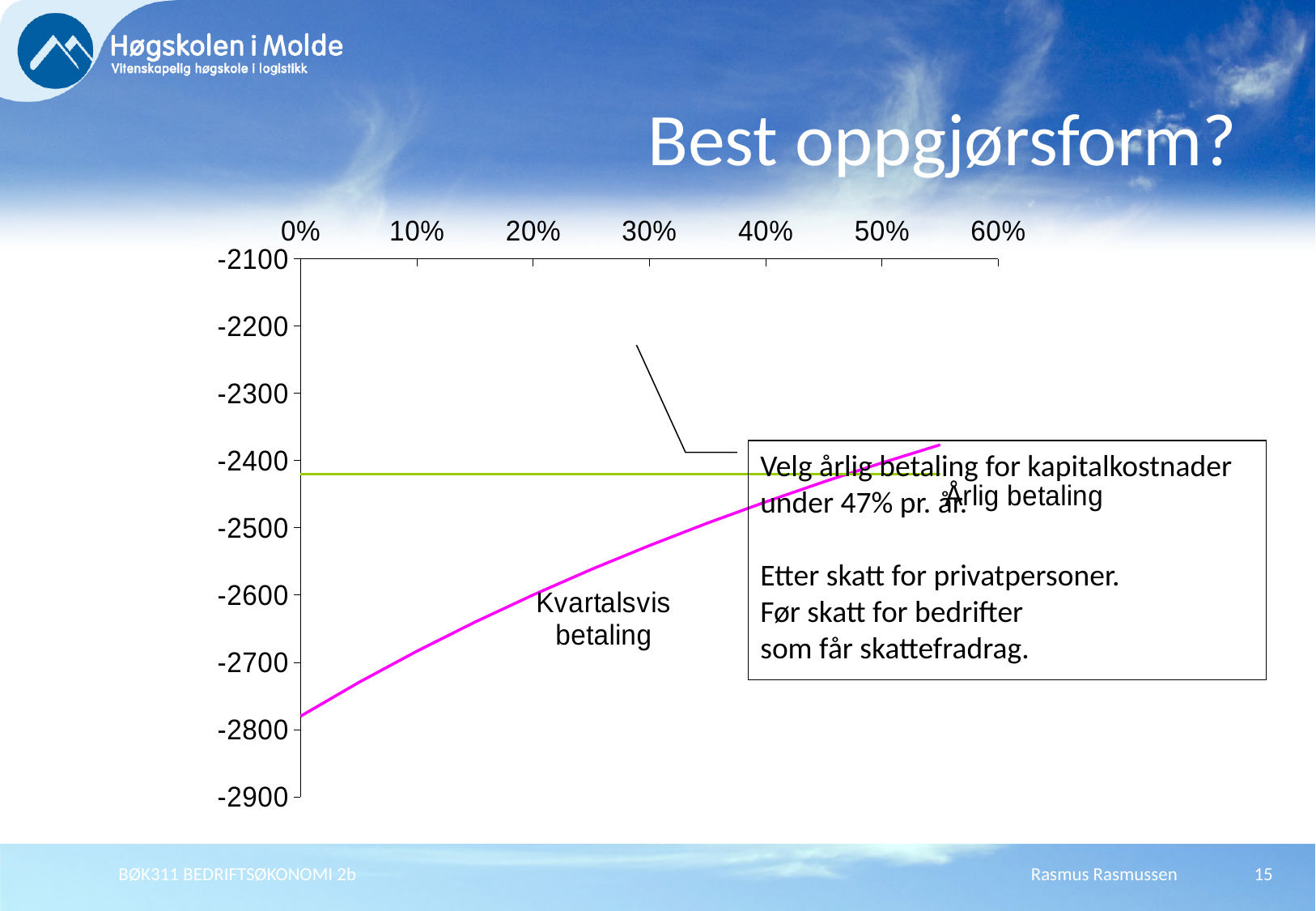
At 0%, which series has the higher value, Årlig betaling or Kvartalsvis betaling? Årlig betaling Is the value of Kvartalsvis betaling at 10% greater or less than -2600? less What is the title of the slide containing the chart? Best oppgjørsform? Does the Årlig betaling line rise, fall or stay flat along the x axis? stays flat Which series reaches the lowest value anywhere on the chart? Kvartalsvis betaling Is the value of Kvartalsvis betaling at 0% greater or less than -2700? less At 20%, which series has the lower value, Årlig betaling or Kvartalsvis betaling? Kvartalsvis betaling Is the value of the Årlig betaling line greater or less than -2500? greater How many series are plotted on the chart? 2 Does the Kvartalsvis betaling line rise or fall as the percentage on the x axis increases? rises According to the text box on the chart, below what annual rate should annual payment (årlig betaling) be chosen? 47% What kind of chart is shown on the slide? line chart